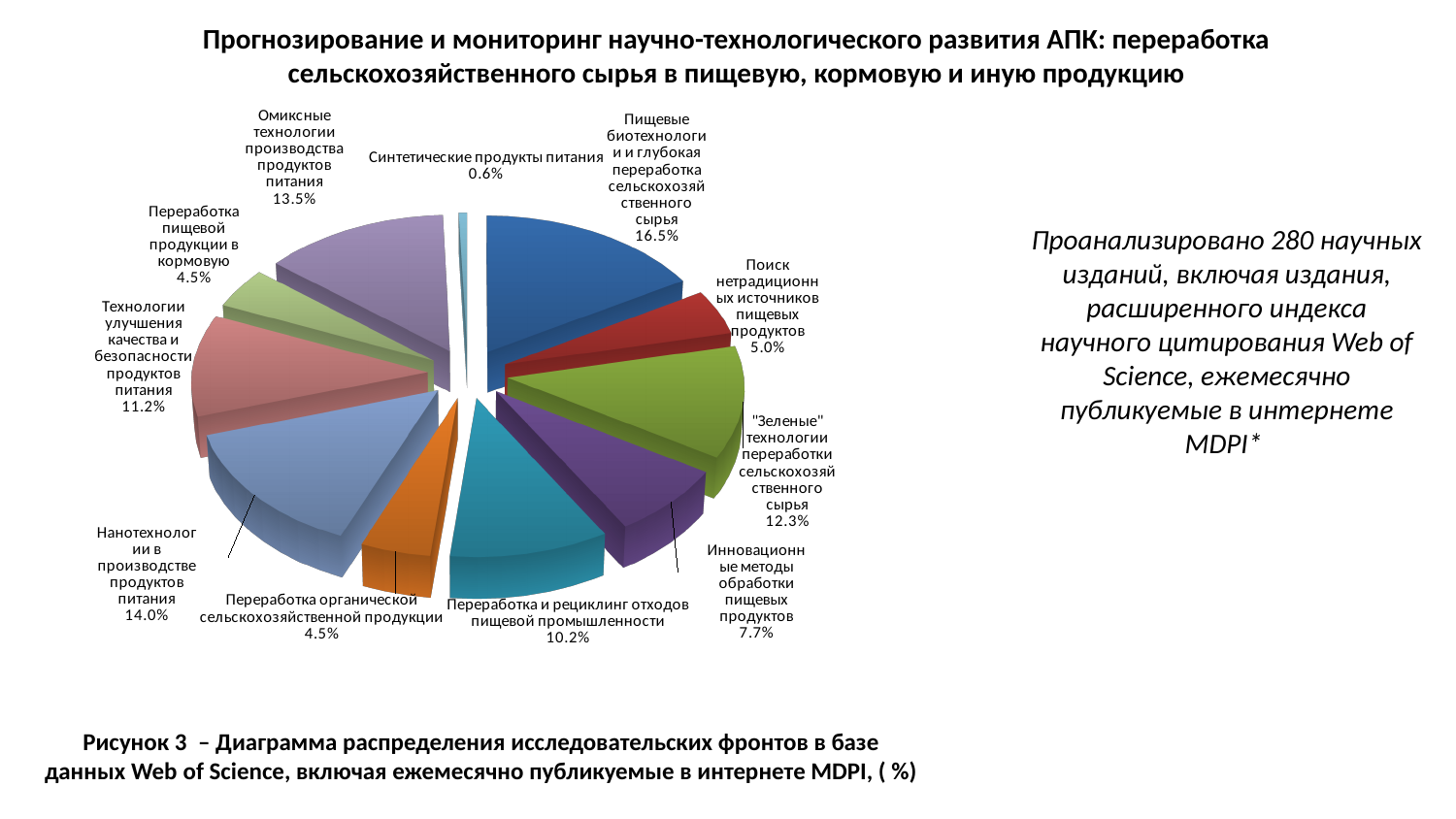
How many slices does the pie chart have? 11 Which category has the largest share of the pie? Пищевые биотехнологии и глубокая переработка сельскохозяйственного сырья Which category has the smallest share of the pie? Синтетические продукты питания What is the value for "Синтетические продукты питания"? 0.6% What is the combined share of "Переработка органической сельскохозяйственной продукции" and "Переработка пищевой продукции в кормовую"? 9.0% According to the figure caption, what number is this figure (Рисунок)? Рисунок 3 What is the value shown for "Нанотехнологии в производстве продуктов питания"? 14.0% What percentage is shown for "Переработка и рециклинг отходов пищевой промышленности"? 10.2% What share does the slice "Пищевые биотехнологии и глубокая переработка сельскохозяйственного сырья" have? 16.5% Which is larger: the share for ""Зеленые" технологии переработки сельскохозяйственного сырья" or for "Технологии улучшения качества и безопасности продуктов питания"? "Зеленые" технологии переработки сельскохозяйственного сырья What is the difference between the shares of "Омиксные технологии производства продуктов питания" and "Поиск нетрадиционных источников пищевых продуктов"? 8.5% What kind of chart is shown on the slide? Pie chart